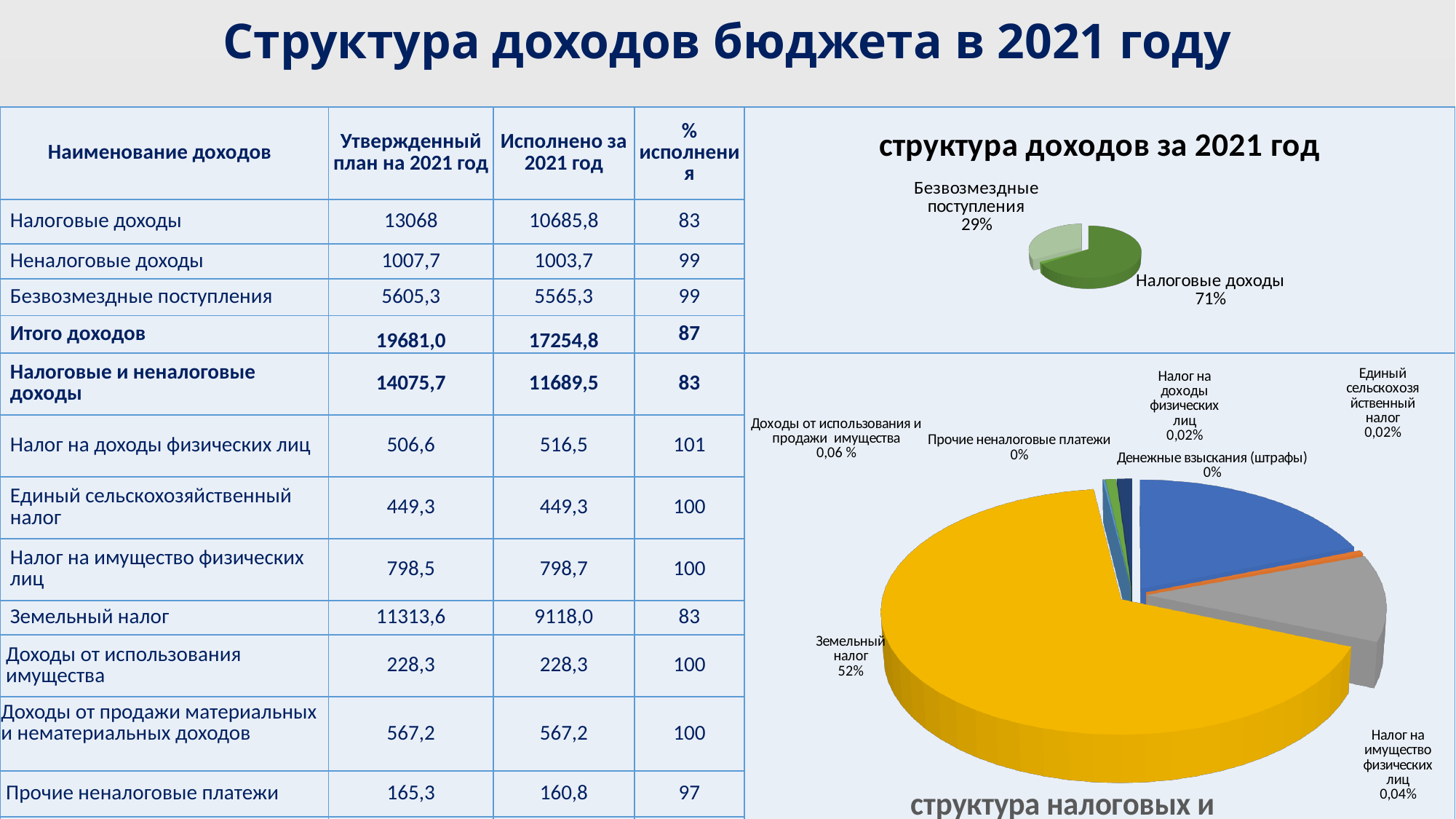
In the pie chart titled "структура доходов за 2021 год", which slice is larger: Налоговые доходы or Безвозмездные поступления? Налоговые доходы In the bottom pie chart on the slide, which category has the largest slice? Земельный налог What kind of chart is the chart titled "структура доходов за 2021 год"? Pie chart In the bottom pie chart on the slide, what share is labelled for Земельный налог? 52% In the pie chart titled "структура доходов за 2021 год", what share is shown for Налоговые доходы? 71% In the bottom pie chart on the slide, what share is labelled for Налог на имущество физических лиц? 0,04% In the pie chart titled "структура доходов за 2021 год", by how many percentage points does Налоговые доходы exceed Безвозмездные поступления? 42 percentage points What is the title of the pie chart in the upper right of the slide? структура доходов за 2021 год What kind of chart is the bottom chart on the slide? Pie chart